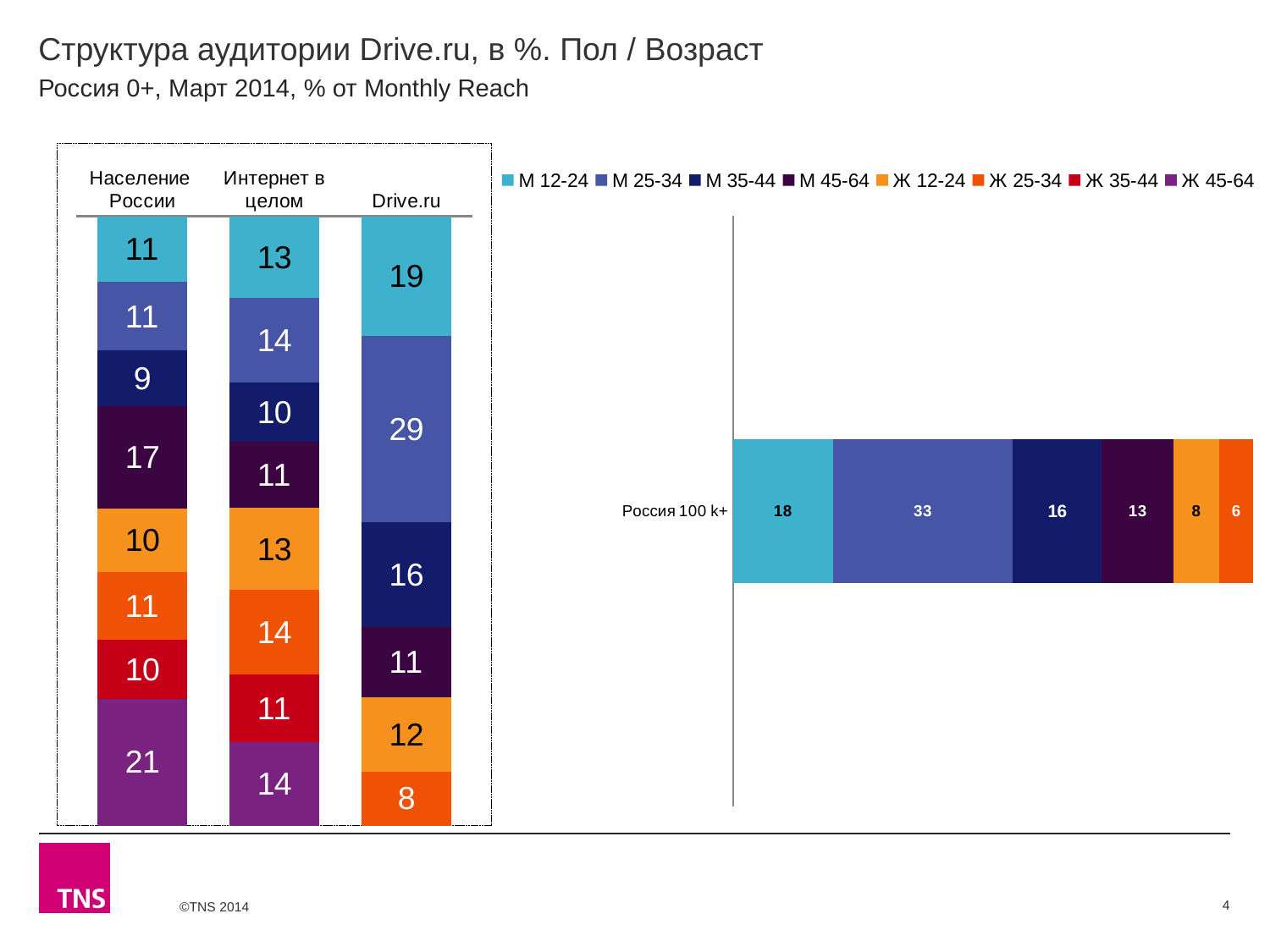
In the right chart (Россия 100 k+), what is the difference between the М 12-24 and М 45-64 values? 5 How many series does the legend list? 8 In the left chart, which segment is the largest in the Drive.ru column? М 25-34 What type of chart is the right chart (Россия 100 k+)? Stacked bar chart In the left chart, what is the value for М 35-44 in the Интернет в целом column? 10 How many columns (categories) does the left stacked bar chart show? 3 In the left chart, what is the value for М 25-34 in the Drive.ru column? 29 In the right chart (Россия 100 k+), what is the value for М 25-34? 33 In the left chart, what is the difference between the М 12-24 values for Drive.ru and Население России? 8 In the left chart, which segment is the smallest in the Население России column? М 35-44 In the left chart, what is the value for Ж 45-64 in the Население России column? 21 In the left chart, which is larger: Ж 12-24 for Drive.ru or Ж 12-24 for Интернет в целом? Интернет в целом